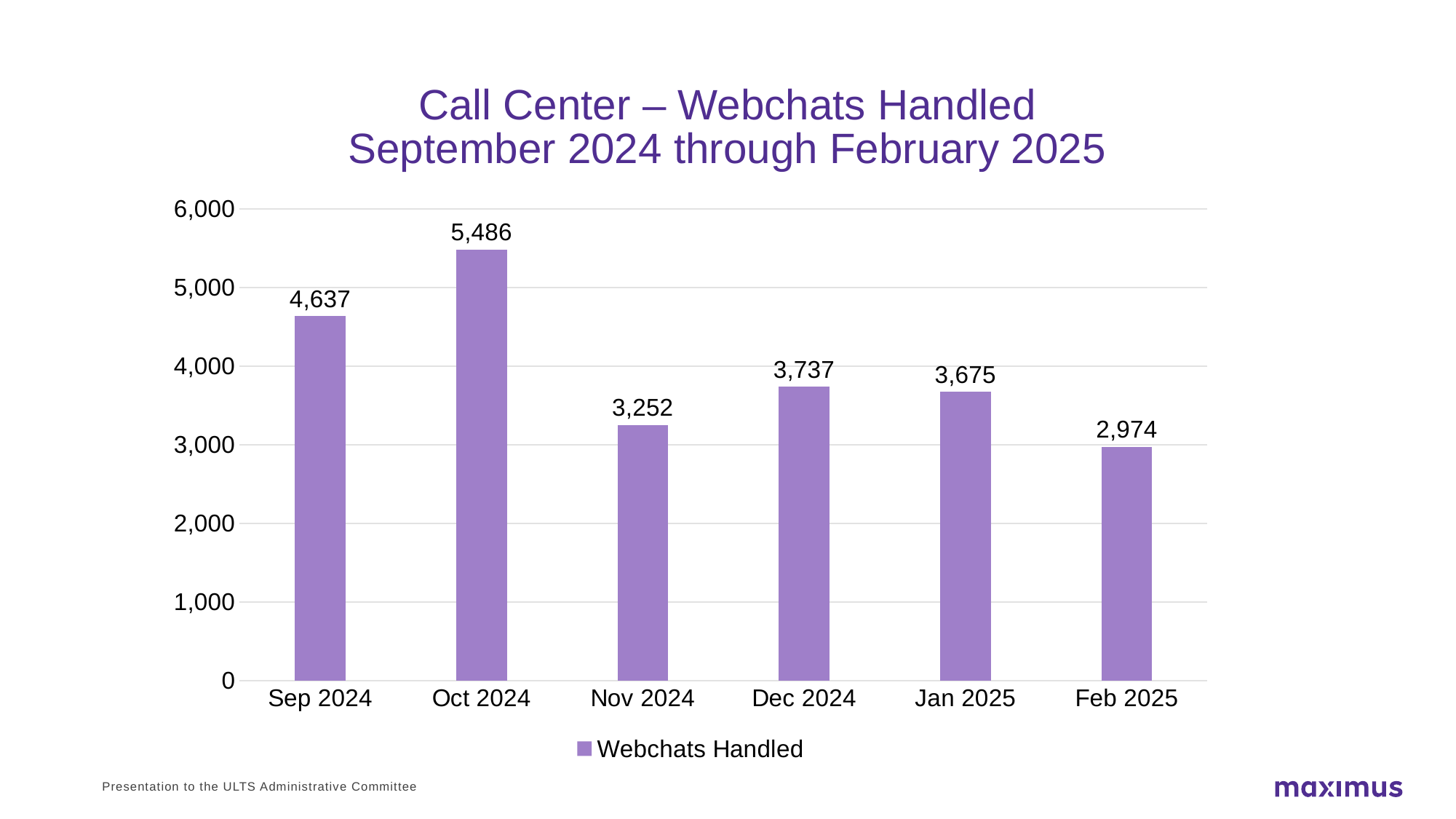
Which is larger, the value for Nov 2024 or the value for Jan 2025? Jan 2025 What kind of chart is shown on the slide? Bar chart What series name does the legend show? Webchats Handled How many months are shown on the x axis? 6 Is the value for Sep 2024 greater or less than 4,000? greater What is the value for Feb 2025? 2,974 Which month has the lowest number of webchats handled? Feb 2025 What is the difference between the values for Dec 2024 and Jan 2025? 62 What is the difference between the values for Oct 2024 and Sep 2024? 849 Which month has the highest number of webchats handled? Oct 2024 How many webchats were handled in Dec 2024? 3,737 How many webchats were handled in Oct 2024? 5,486